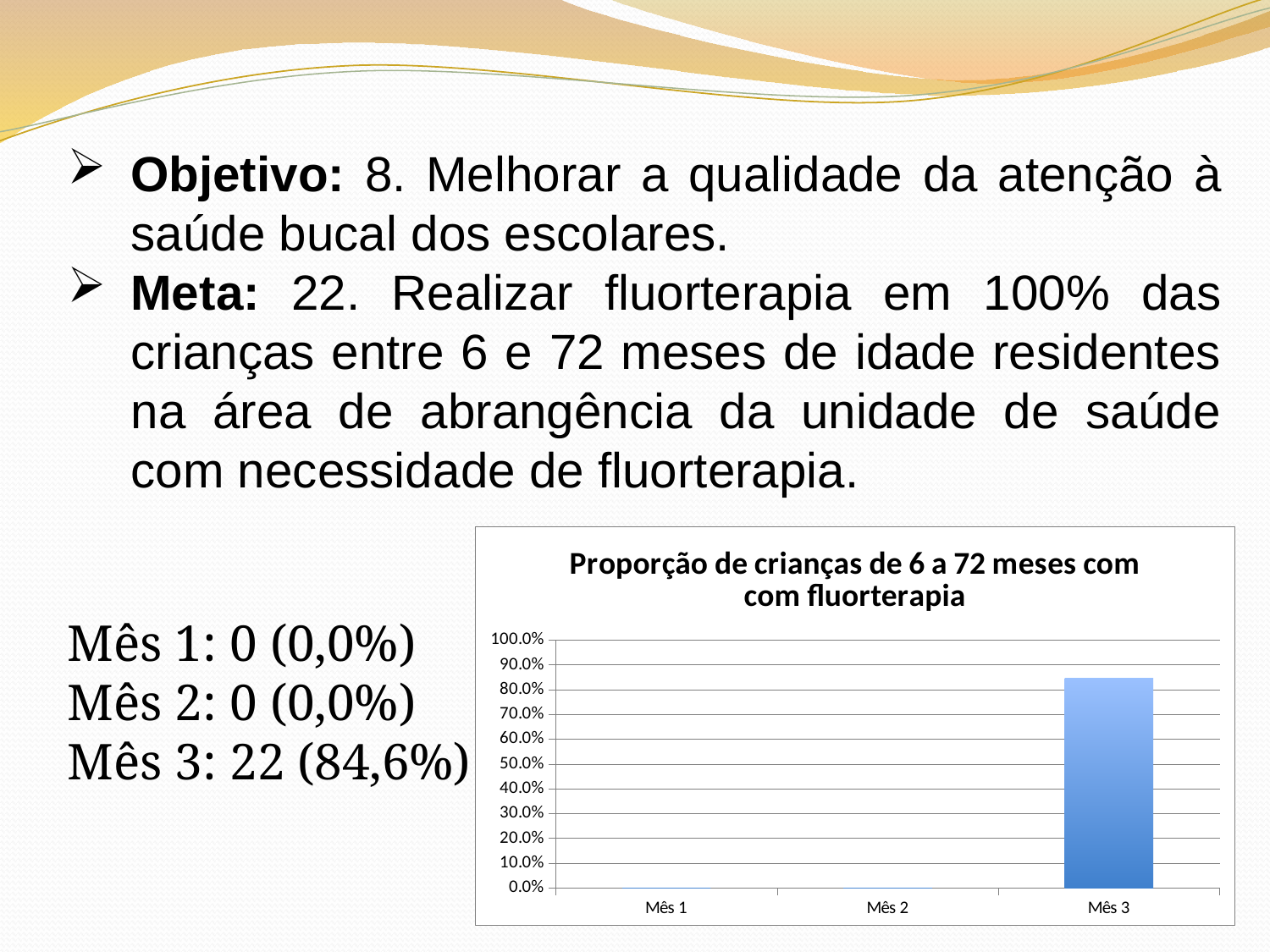
What is the value for Mês 1 in the chart? 0.0% What kind of chart is shown on the slide? bar chart Is the value for Mês 3 greater or less than 80.0%? greater Which is larger, the value for Mês 2 or the value for Mês 3? Mês 3 How many categories are shown on the x axis of the chart? 3 What is the title of the chart? Proporção de crianças de 6 a 72 meses com com fluorterapia Is the value for Mês 3 greater or less than 90.0%? less Do the values rise or fall from Mês 1 to Mês 3? rise Which month has the highest value in the chart? Mês 3 What is the value for Mês 2 in the chart? 0.0% Is the value for Mês 3 greater or less than 50.0%? greater What colour is the bar for Mês 3? blue